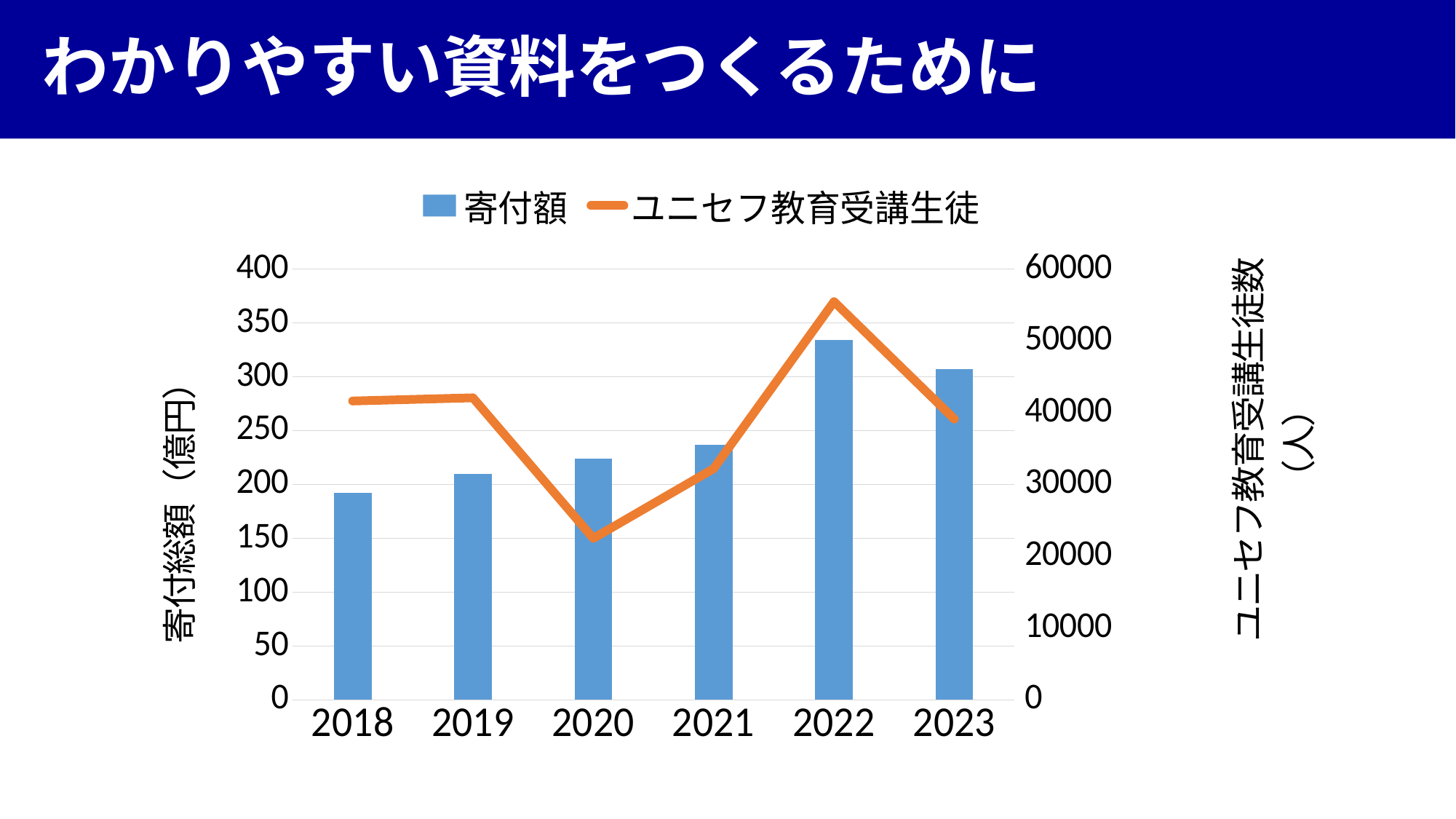
In which year does the ユニセフ教育受講生徒 line reach its lowest point? 2020 What kind of chart is shown on the slide? A combined bar and line chart Which year has the lowest 寄付額 bar? 2018 Is the 寄付額 value for 2018 greater or less than 200? less Is the 寄付額 value for 2022 greater or less than 300? greater Which year has the highest 寄付額 bar? 2022 How many years are shown on the x axis? 6 How many series does the legend list? 2 What is the title of the left vertical axis? 寄付総額（億円） In which year does the ユニセフ教育受講生徒 line reach its highest point? 2022 Which year has the larger 寄付額 bar, 2021 or 2023? 2023 Is the ユニセフ教育受講生徒 value for 2020 greater or less than 30000? less